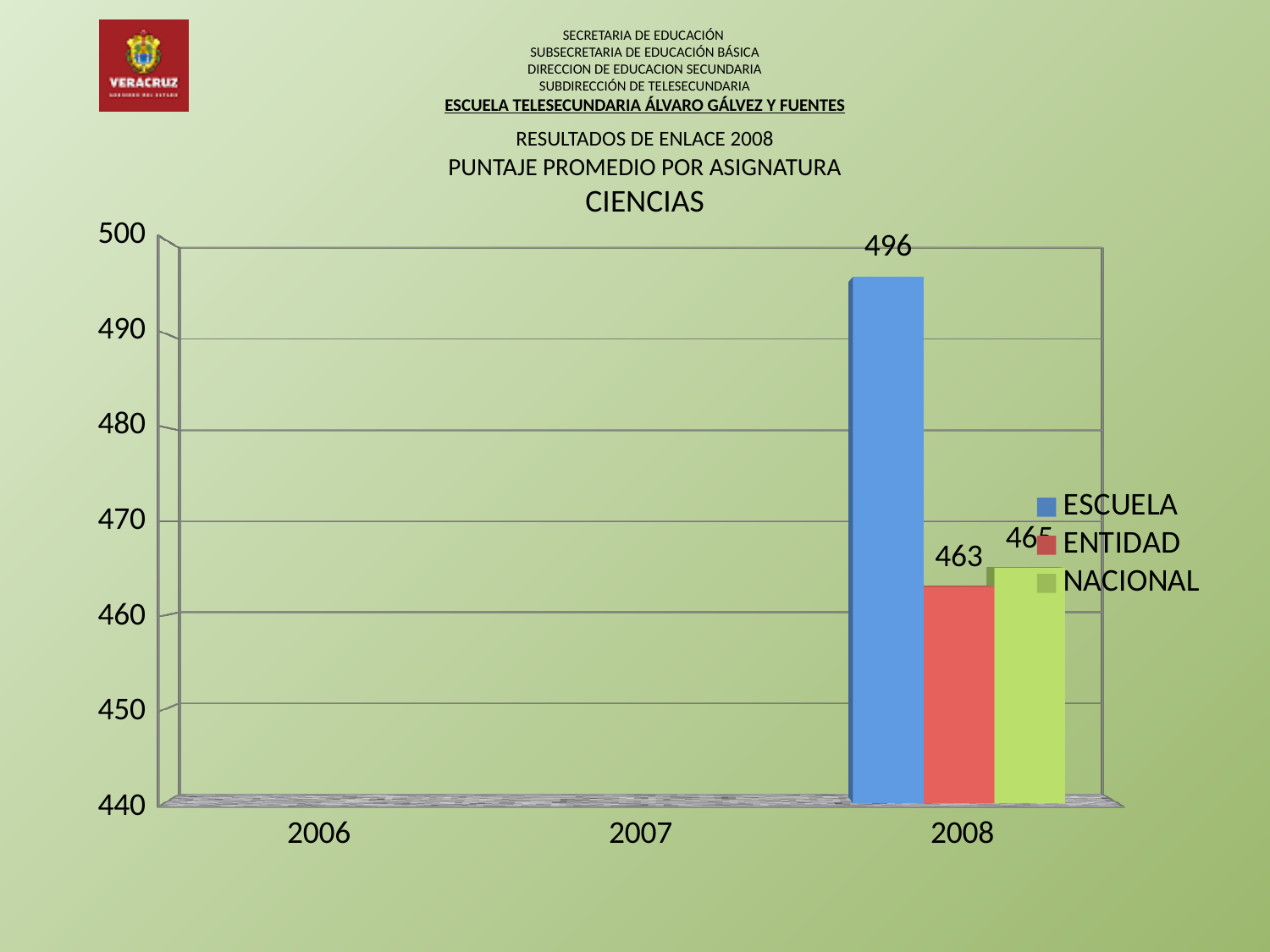
What is the value of the ESCUELA bar for 2008? 496 What is the value of the ENTIDAD bar for 2008? 463 How many series does the legend list? 3 Which series has the highest value in 2008? ESCUELA What is the difference between the ESCUELA and ENTIDAD values for 2008? 33 Is the value for ESCUELA in 2008 greater or less than 490? greater How many years are shown on the x axis? 3 Is the value for NACIONAL in 2008 greater or less than 470? less Which subject (asignatura) does the chart title name? CIENCIAS Which is larger in 2008, the ESCUELA value or the ENTIDAD value? ESCUELA What kind of chart is shown on the slide? bar chart What colour represents the ESCUELA series in the legend? blue